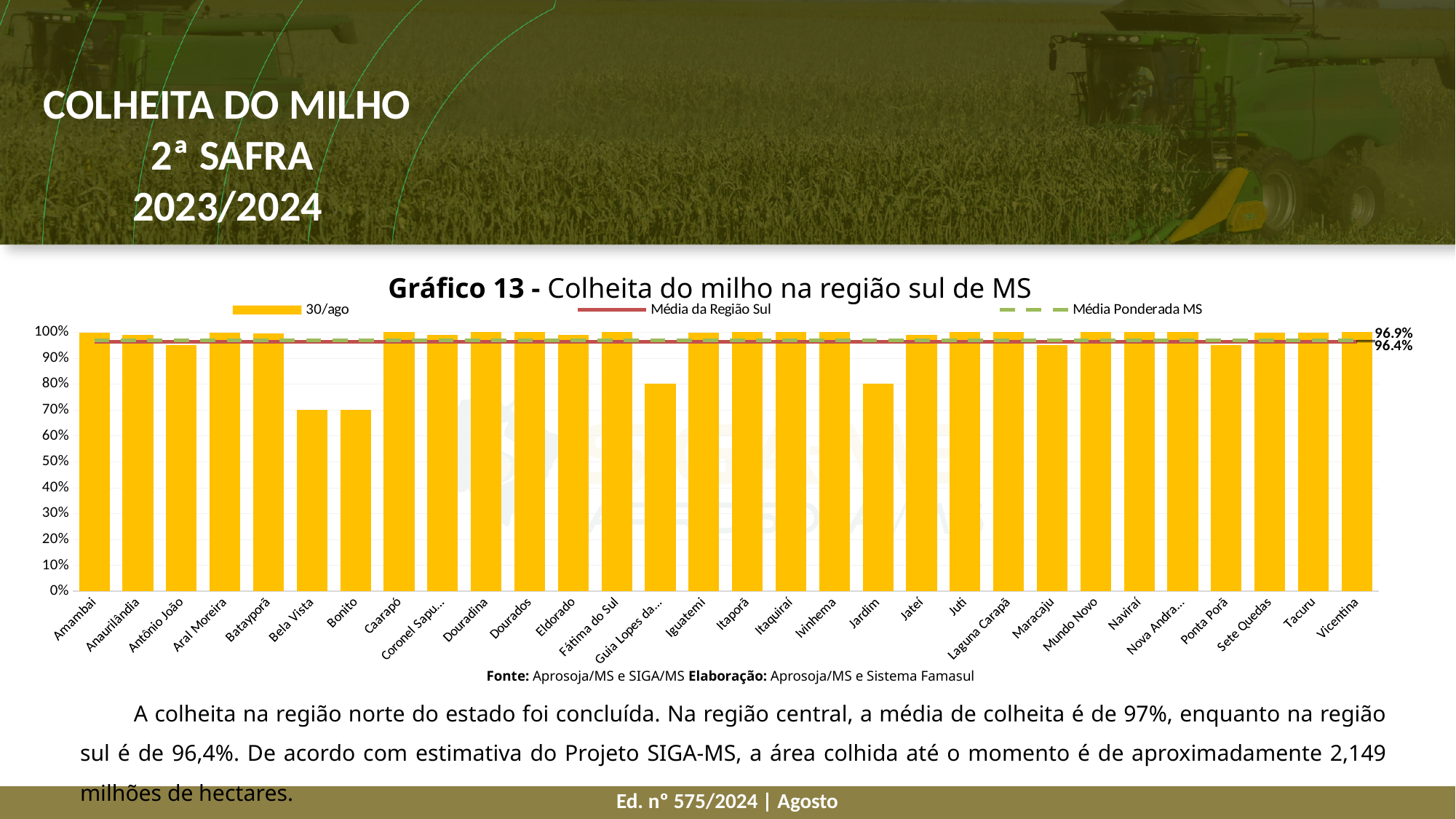
How many series does the legend of the chart list? 3 How many municipalities are shown on the x axis of the chart? 30 What kind of chart is Gráfico 13? bar chart Is the value for Maracaju greater or less than 90%? greater What is the difference between the values for Jardim and Bela Vista? 10 percentage points What is the harvest value for Bonito? 70% What value is labelled for the Média da Região Sul line? 96.4% Which legend entry is represented by the green dashed line? Média Ponderada MS What is the harvest value for Bela Vista? 70% Is the value for Antônio João greater or less than 90%? greater Which is larger, the value for Jardim or the value for Bela Vista? Jardim What is the harvest value for Jardim? 80%